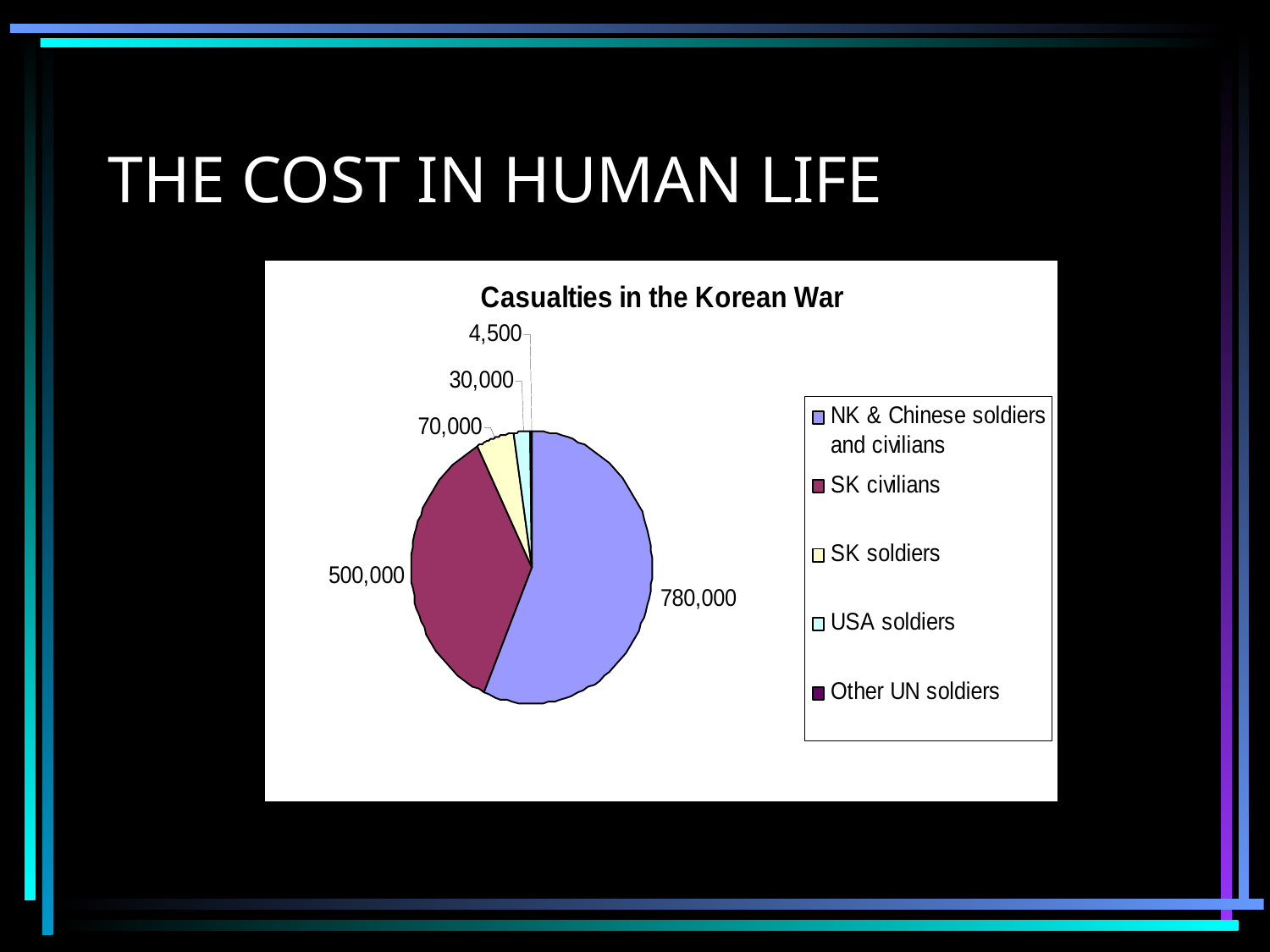
How many casualties are shown for Other UN soldiers? 4,500 Which category has the largest slice of the pie? NK & Chinese soldiers and civilians How many casualties are shown for NK & Chinese soldiers and civilians? 780,000 How many casualties are shown for SK civilians? 500,000 What is the title of the chart? Casualties in the Korean War How many categories does the legend list? 5 How many casualties are shown for USA soldiers? 30,000 What type of chart is shown on the slide? pie chart How many casualties are shown for SK soldiers? 70,000 Which is larger, the casualties for SK soldiers or for USA soldiers? SK soldiers Which category has the smallest slice of the pie? Other UN soldiers What is the difference between the casualties for NK & Chinese soldiers and civilians and for SK civilians? 280,000